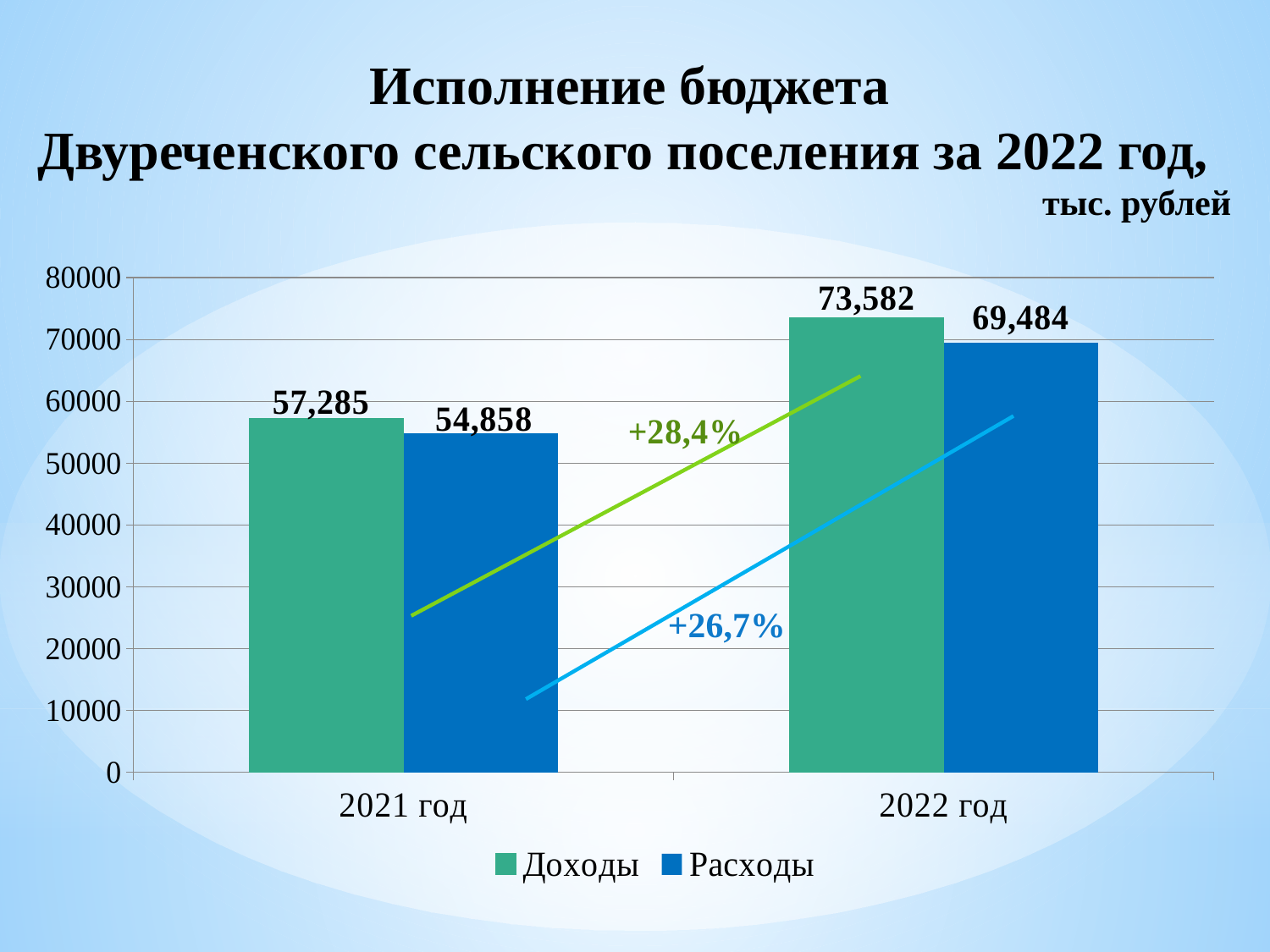
What is the value of Доходы for 2022 год? 73,582 What is the value of Доходы for 2021 год? 57,285 What is the value of Расходы for 2022 год? 69,484 Which year has the higher value of Доходы? 2022 год What is the value of Расходы for 2021 год? 54,858 What percentage growth is shown for Расходы from 2021 год to 2022 год? +26,7% In 2021 год, which is larger: Доходы or Расходы? Доходы Which bar has the lowest value on the chart? Расходы, 2021 год How many series does the legend list? 2 What is the difference between Доходы and Расходы in 2022 год? 4,098 What is the difference between Доходы in 2022 год and Доходы in 2021 год? 16,297 What kind of chart is shown on the slide? Bar chart